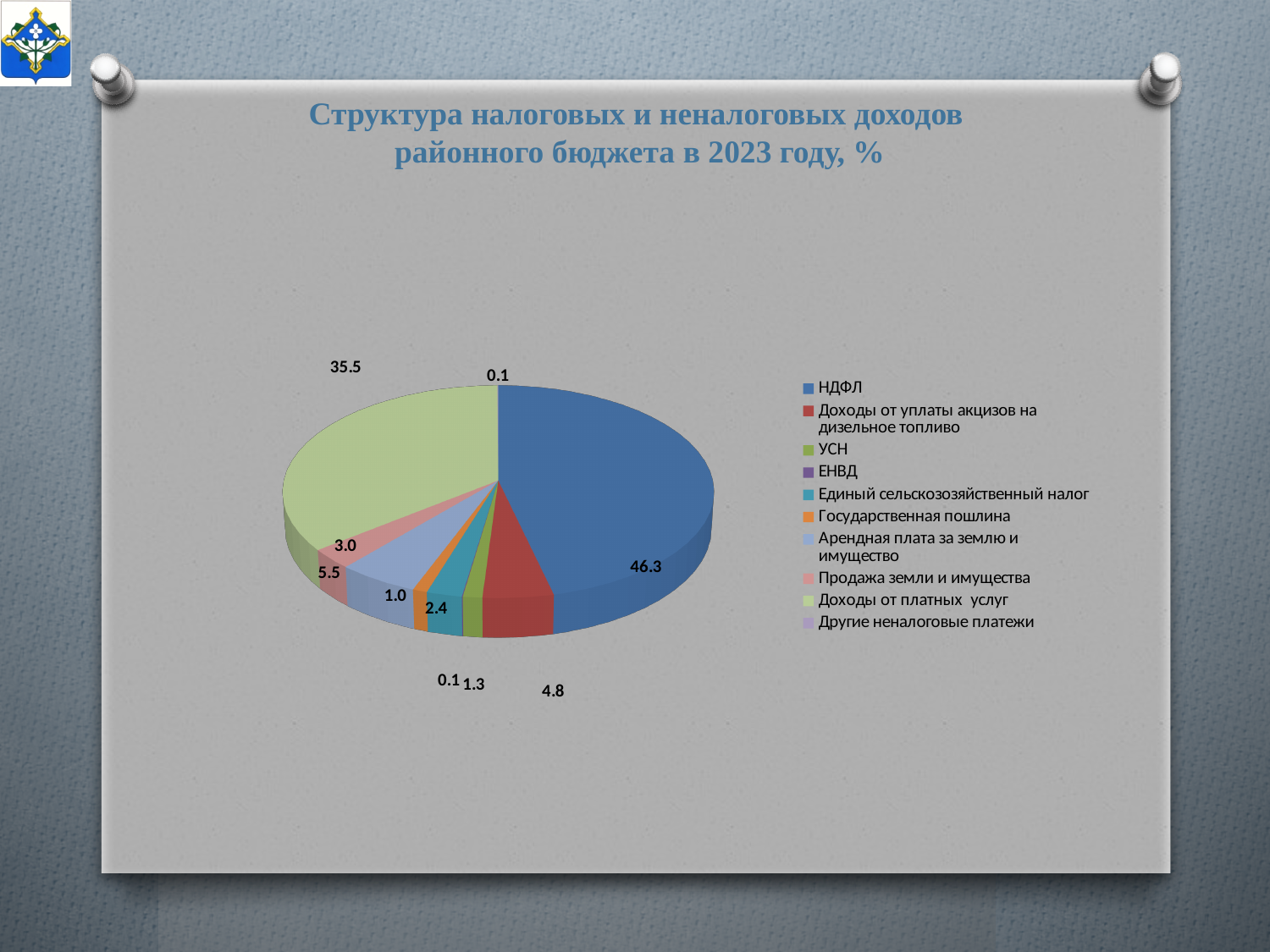
What is the value shown for Единый сельскохозяйственный налог? 2.4 Which category has the largest share of the pie? НДФЛ What is the title of the chart? Структура налоговых и неналоговых доходов районного бюджета в 2023 году, % What is the value shown for Доходы от платных услуг? 35.5 What is the value shown for Арендная плата за землю и имущество? 5.5 What is the value shown for Доходы от уплаты акцизов на дизельное топливо? 4.8 Which is larger, the value for Арендная плата за землю и имущество or the value for Продажа земли и имущества? Арендная плата за землю и имущество What is the value shown for Государственная пошлина? 1.0 What is the difference between the values for НДФЛ and Доходы от платных услуг? 10.8 How many categories does the legend of the pie chart list? 10 What kind of chart is shown on the slide? pie chart What is the value shown for НДФЛ? 46.3